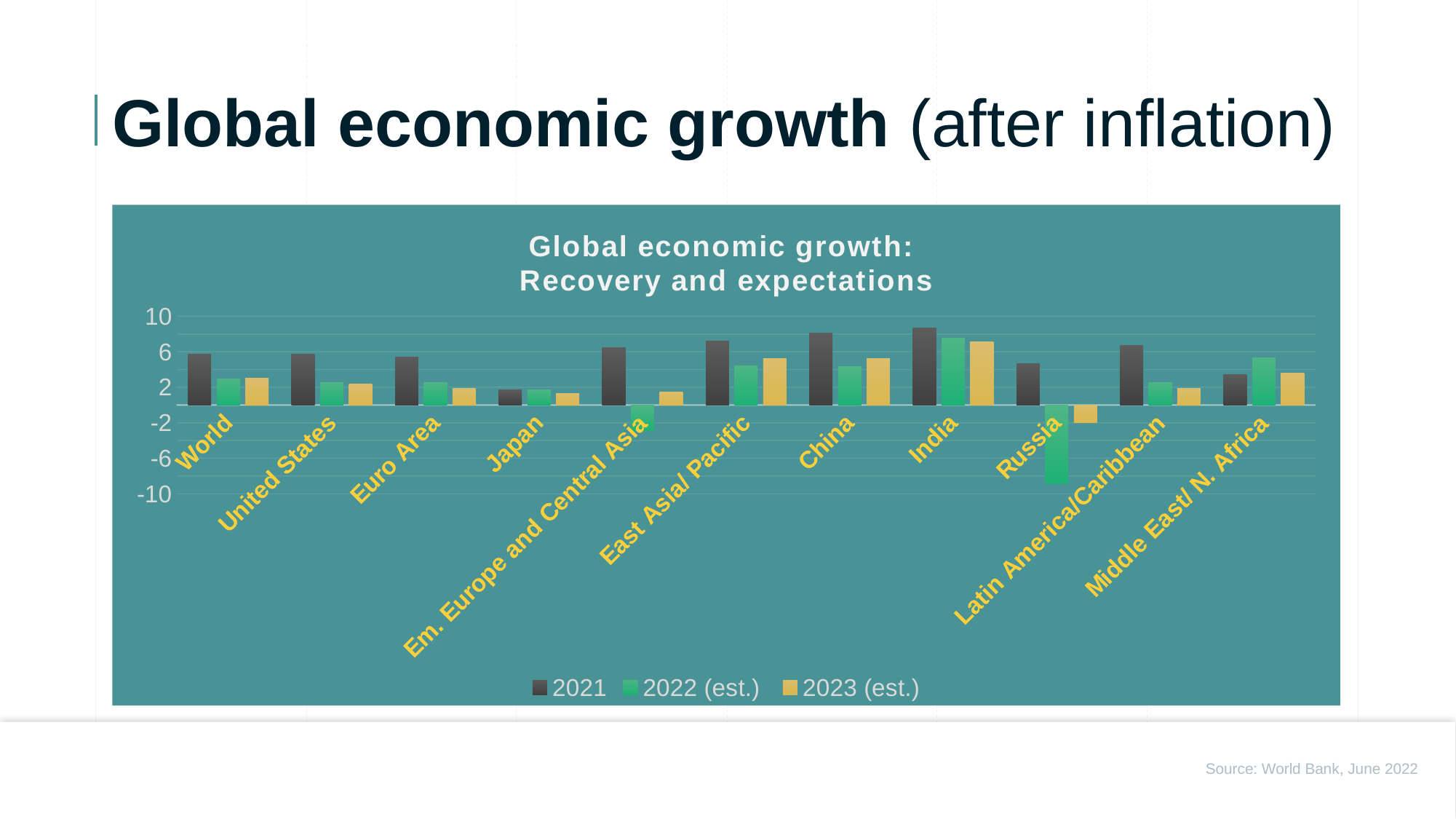
Which region has the lowest 2022 (est.) value? Russia How many regions/countries are shown on the x axis? 11 Which is larger for Middle East/N. Africa: the 2021 value or the 2022 (est.) value? 2022 (est.) Is the 2021 value for East Asia/Pacific greater or less than 6? greater What kind of chart is shown on the slide? bar chart How many series does the legend list? 3 Is the 2022 (est.) value for Russia greater or less than -6? less Is the 2023 (est.) value for Japan greater or less than 2? less Which is larger for China: the 2021 value or the 2022 (est.) value? 2021 Which region has the highest 2021 value? India What is the title of the chart? Global economic growth: Recovery and expectations